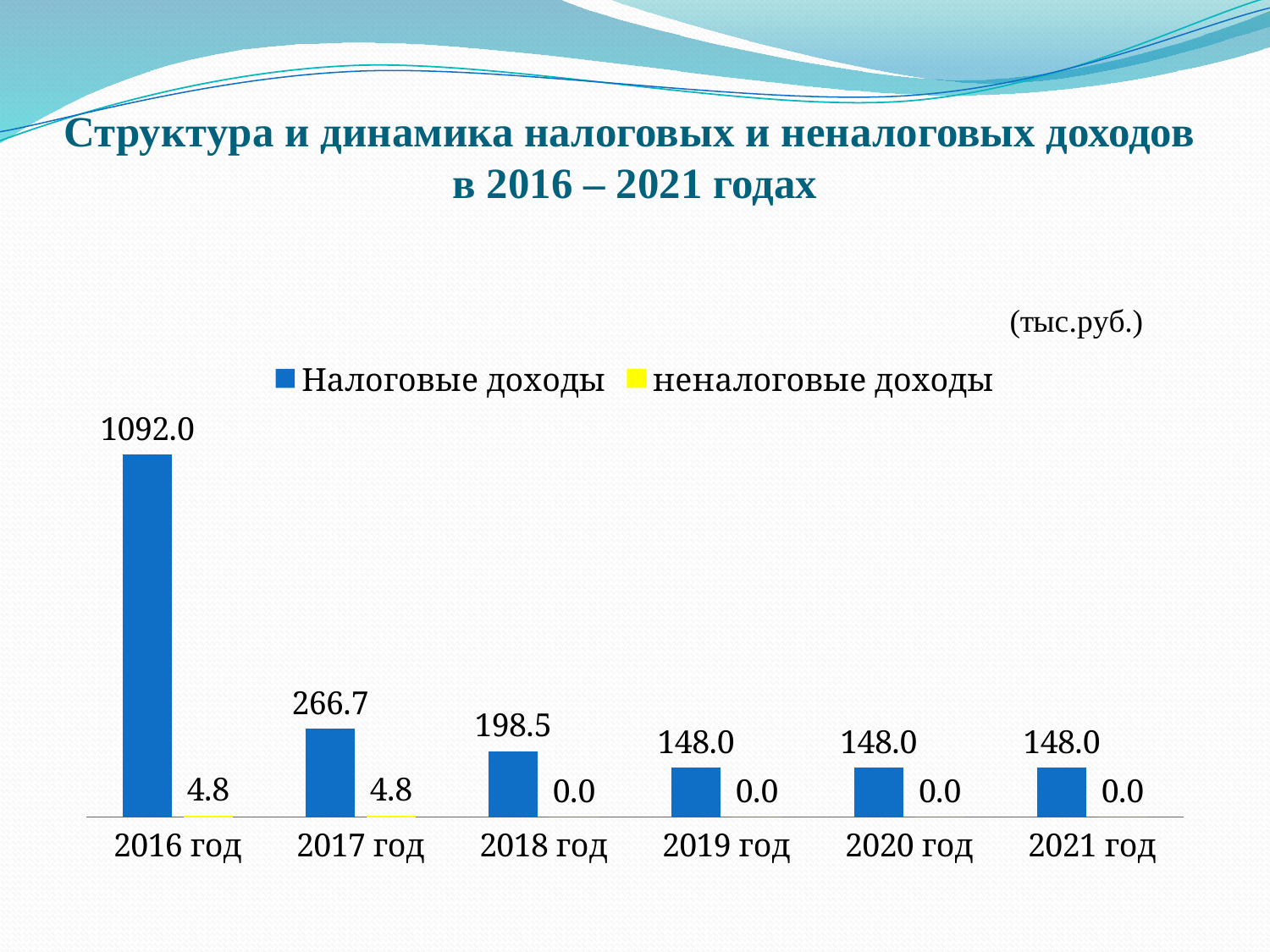
How many years are shown on the x axis? 6 What is the value of неналоговые доходы for 2020 год? 0.0 Do the values of Налоговые доходы rise or fall from 2016 год to 2019 год? fall What is the difference between Налоговые доходы in 2016 год and 2017 год? 825.3 What kind of chart is shown on the slide? bar chart How many series does the legend list? 2 Which year has the highest value of Налоговые доходы? 2016 год What is the difference between Налоговые доходы in 2017 год and 2018 год? 68.2 What is the value of Налоговые доходы for 2018 год? 198.5 What is the value of неналоговые доходы for 2017 год? 4.8 What is the value of Налоговые доходы for 2016 год? 1092.0 Which is larger, Налоговые доходы in 2018 год or in 2019 год? 2018 год